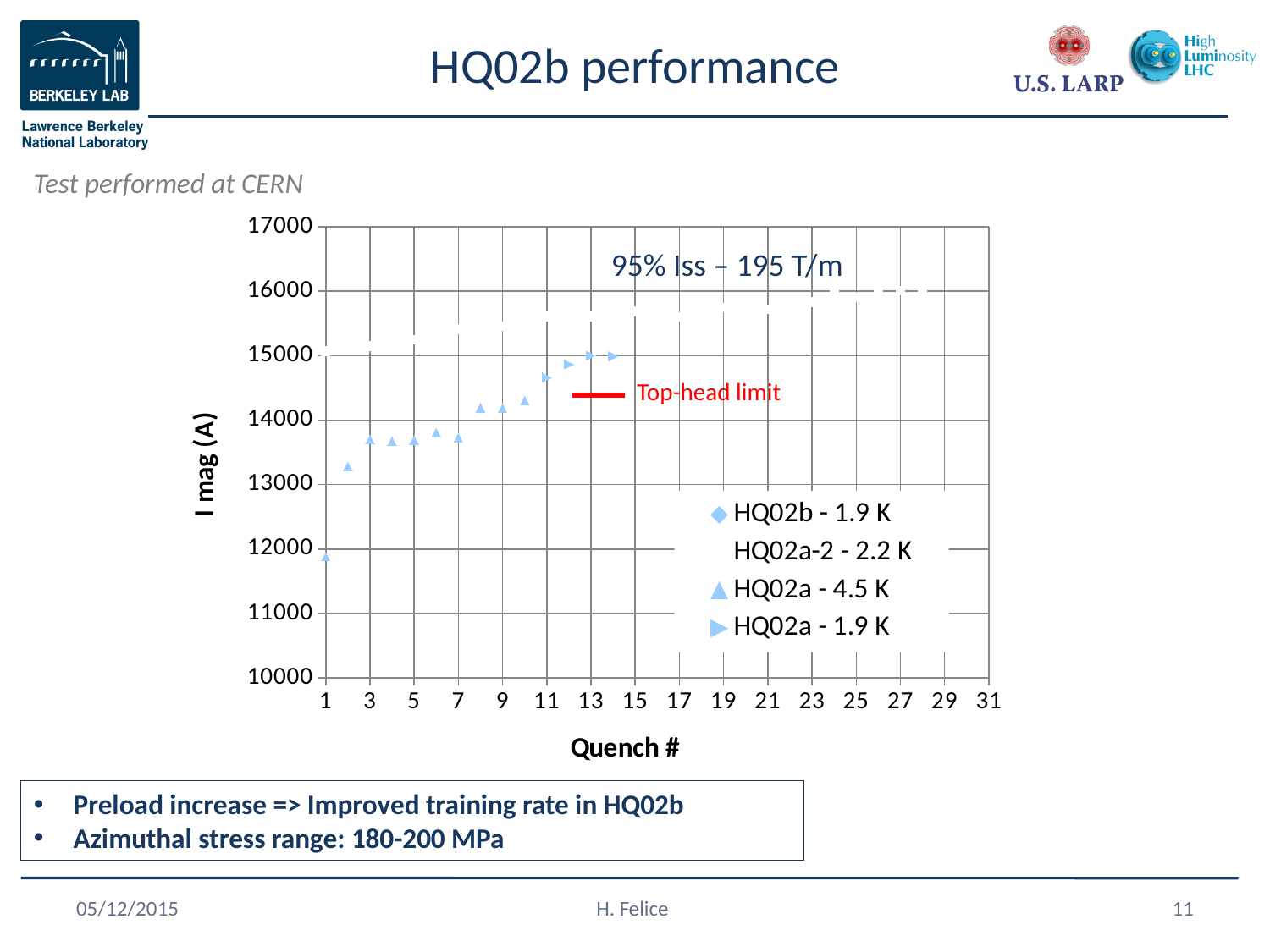
Is the value for quench 6 greater or less than 14000? less What is the title of the x axis of the chart? Quench # Is the value for quench 11 greater or less than 14000? greater How many series does the chart legend list? 4 What is the title of the y axis of the chart? I mag (A) Is the value for quench 2 greater or less than 13000? greater Which series has the highest plotted points on the chart? HQ02a - 1.9 K Which series has the lowest plotted point on the chart? HQ02a - 4.5 K What kind of chart is shown on the slide? scatter chart Do the plotted values generally rise or fall as the quench number increases? rise